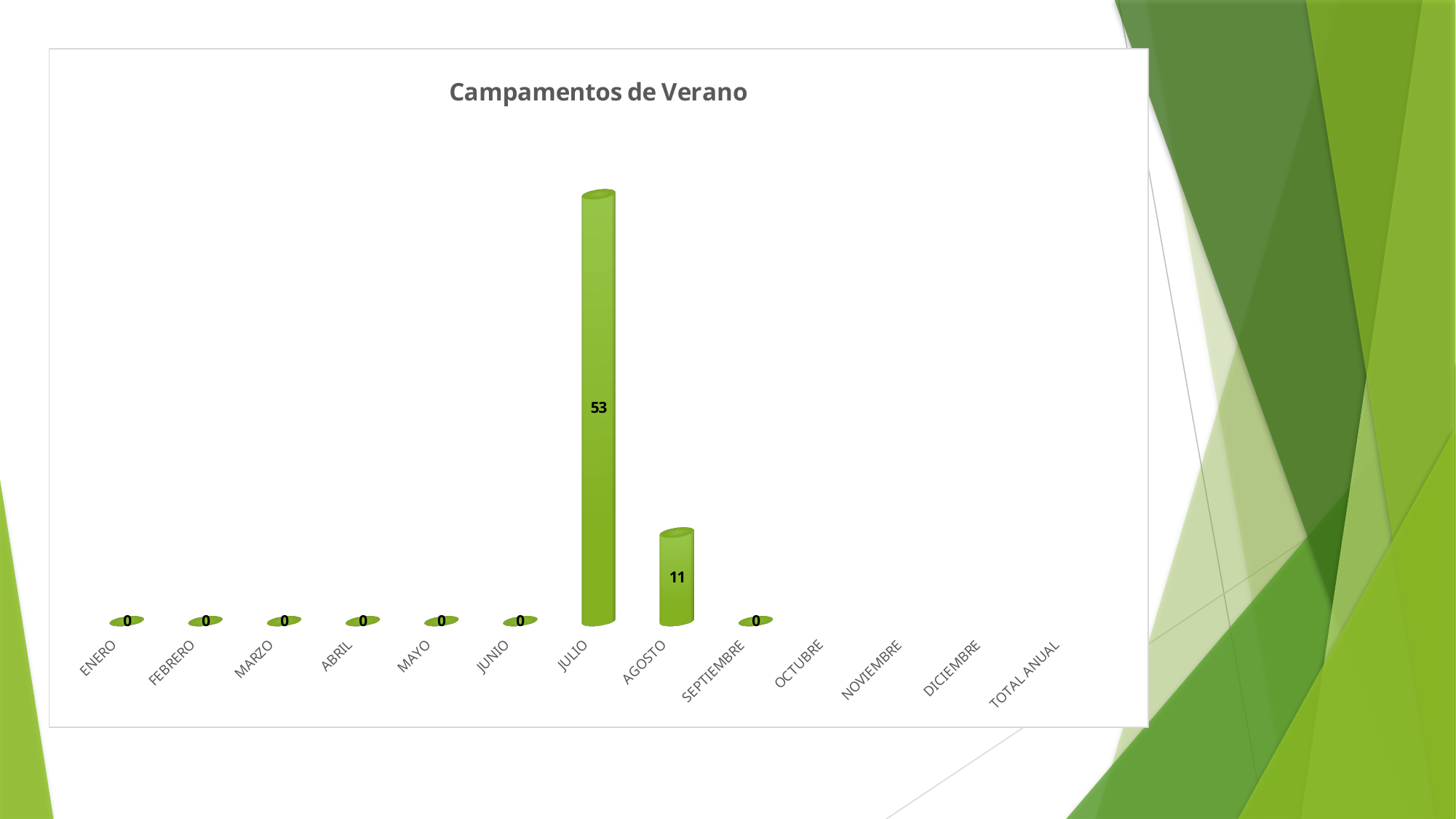
What is the value for ENERO? 0 What is the difference between the values for JULIO and AGOSTO? 42 Which month has the highest value? JULIO What colour are the bars in the chart? green What type of chart is shown on the slide? bar chart How many months show a value of 0? 7 What is the value for AGOSTO? 11 How many category labels are shown on the x axis? 13 Which is larger, the value for JULIO or the value for AGOSTO? JULIO What is the title of the chart? Campamentos de Verano What is the value for JULIO? 53 What is the value for SEPTIEMBRE? 0